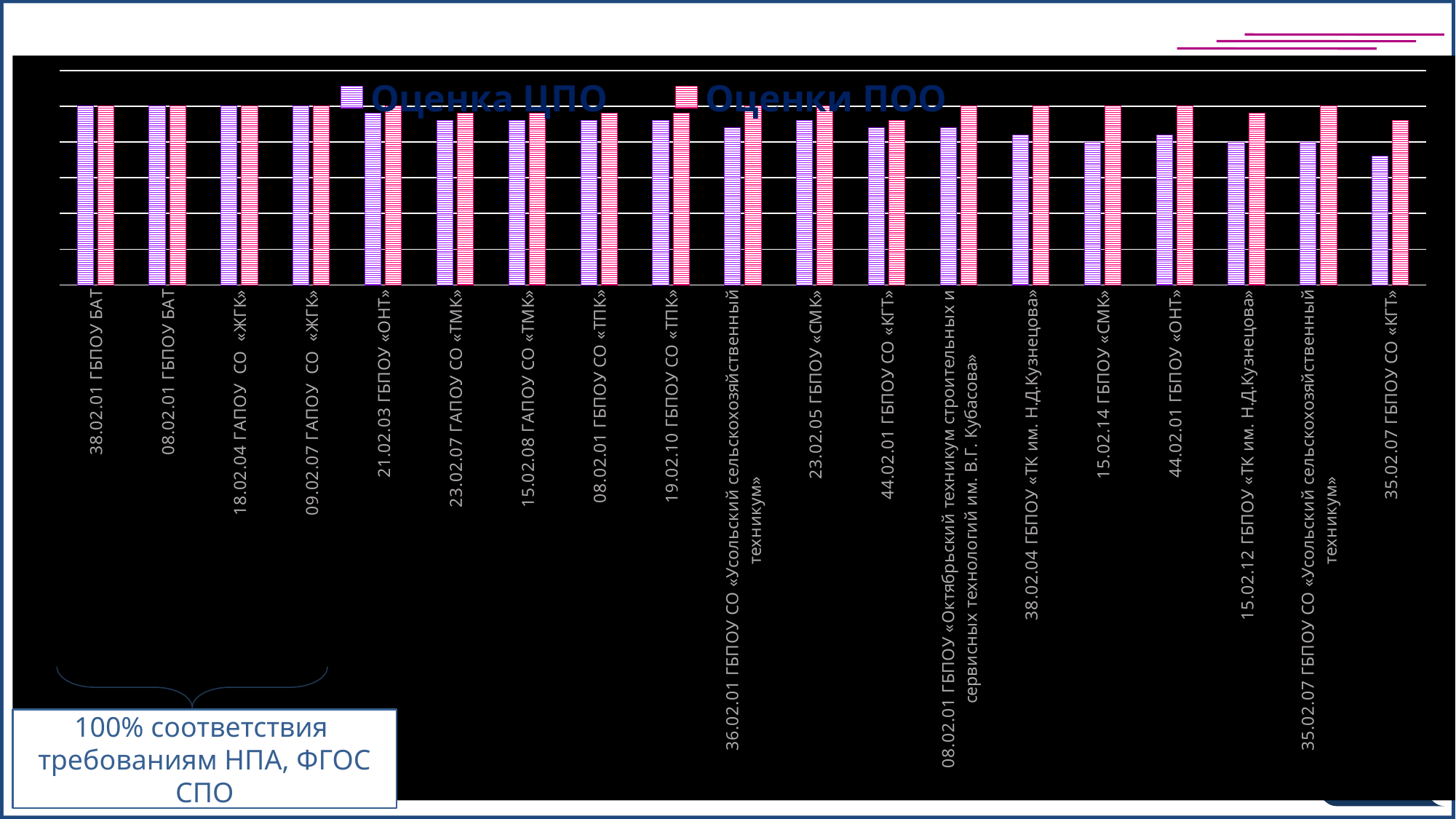
Do the Оценка ЦПО values generally rise or fall from left to right along the x axis? fall For 38.02.04 ГБПОУ «ТК им. Н.Д.Кузнецова», is the Оценка ЦПО value larger or smaller than the Оценки ПОО value? smaller What are the two series named in the legend? Оценка ЦПО and Оценки ПОО What is the first category on the left of the x axis? 38.02.01 ГБПОУ БАТ Which colour represents the Оценки ПОО series? pink How many categories (programmes/institutions) are shown along the x axis? 19 What kind of chart is shown on the slide? bar chart Which category has the lowest value for the Оценка ЦПО series? 35.02.07 ГБПОУ СО «КГТ» For 15.02.14 ГБПОУ «СМК», which series has the larger value, Оценка ЦПО or Оценки ПОО? Оценки ПОО How many series does the legend list? 2 For 35.02.07 ГБПОУ СО «КГТ», which series has the larger value, Оценка ЦПО or Оценки ПОО? Оценки ПОО